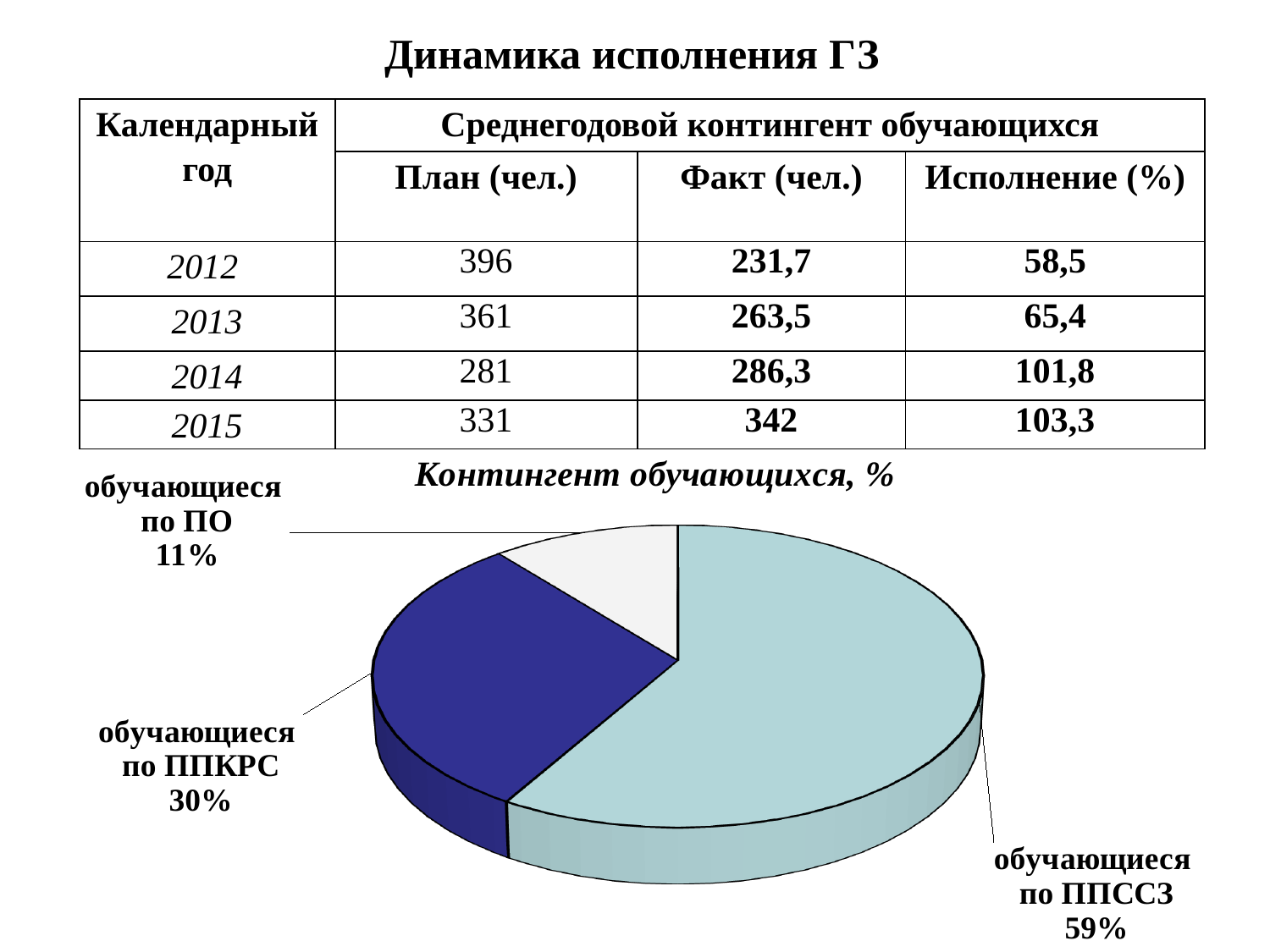
By how many percentage points does the share of "обучающиеся по ППССЗ" exceed the share of "обучающиеся по ППКРС"? 29 How many slices does the pie chart have? 3 What is the title of the pie chart? Контингент обучающихся, % What share of the pie is labelled "обучающиеся по ПО"? 11% What colour is the slice for "обучающиеся по ППКРС" in the pie chart? dark blue Which category has the largest slice in the pie chart? обучающиеся по ППССЗ Which category has the smallest slice in the pie chart? обучающиеся по ПО What kind of chart is shown on the slide? pie chart What share of the pie is labelled "обучающиеся по ППКРС"? 30% Which is larger in the pie chart: the share of "обучающиеся по ППКРС" or the share of "обучающиеся по ПО"? обучающиеся по ППКРС What share of the pie is labelled "обучающиеся по ППССЗ"? 59% By how many percentage points does the share of "обучающиеся по ППКРС" exceed the share of "обучающиеся по ПО"? 19